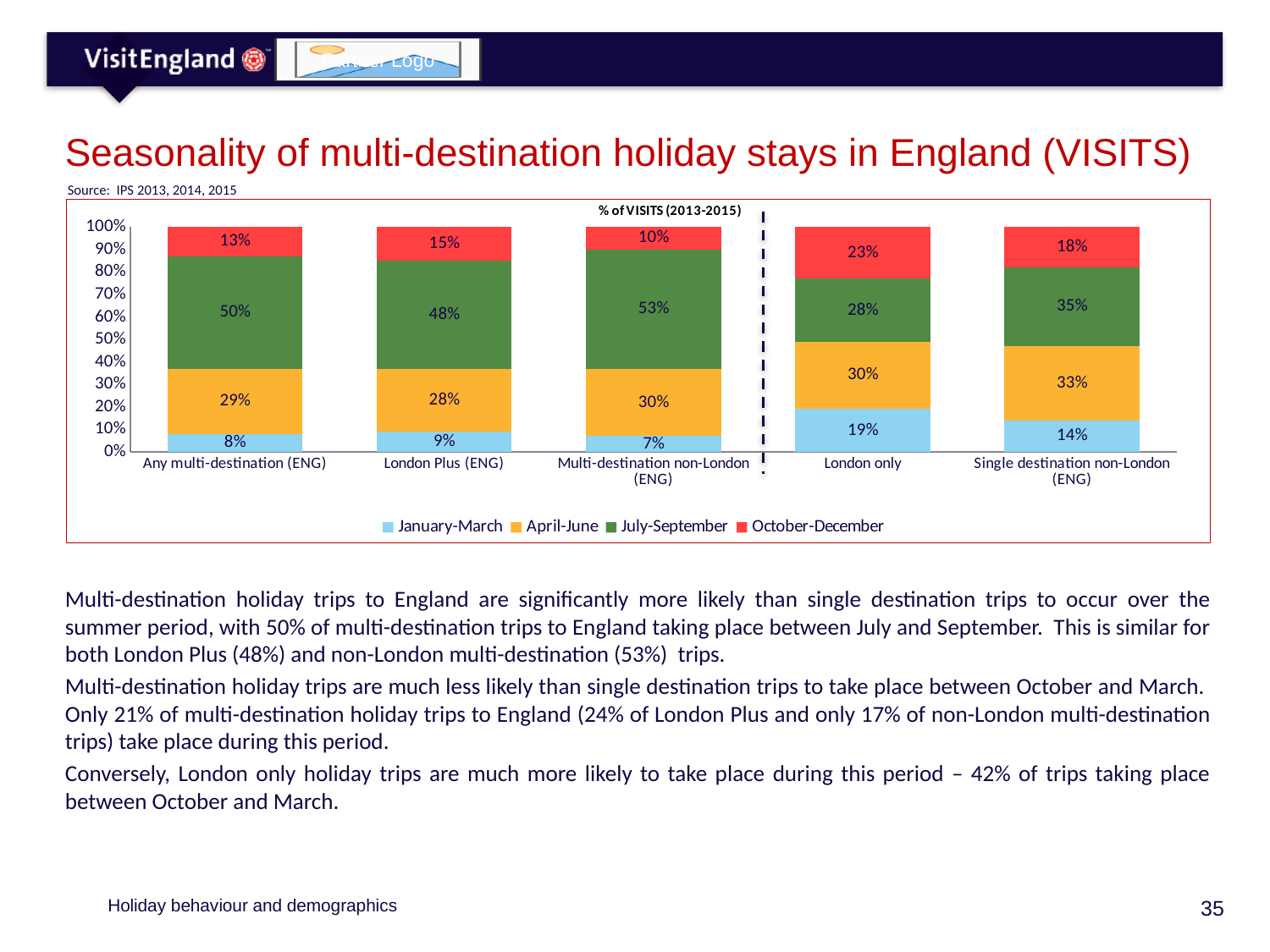
Which is larger: the April-June share for Single destination non-London (ENG) or for London Plus (ENG)? Single destination non-London (ENG) Which category has the lowest January-March share? Multi-destination non-London (ENG) What is the October-December value for London Plus (ENG)? 15% Which colour represents July-September in the chart? Green What is the difference between the July-September shares for Any multi-destination (ENG) and London only? 22% How many series does the legend list? 4 What is the combined share of January-March and October-December for London only? 42% Which category has the highest July-September share? Multi-destination non-London (ENG) What is the July-September share for Multi-destination non-London (ENG)? 53% What percentage of visits for London only occur in January-March? 19% How many categories are shown on the x axis? 5 What kind of chart is shown? Stacked bar chart